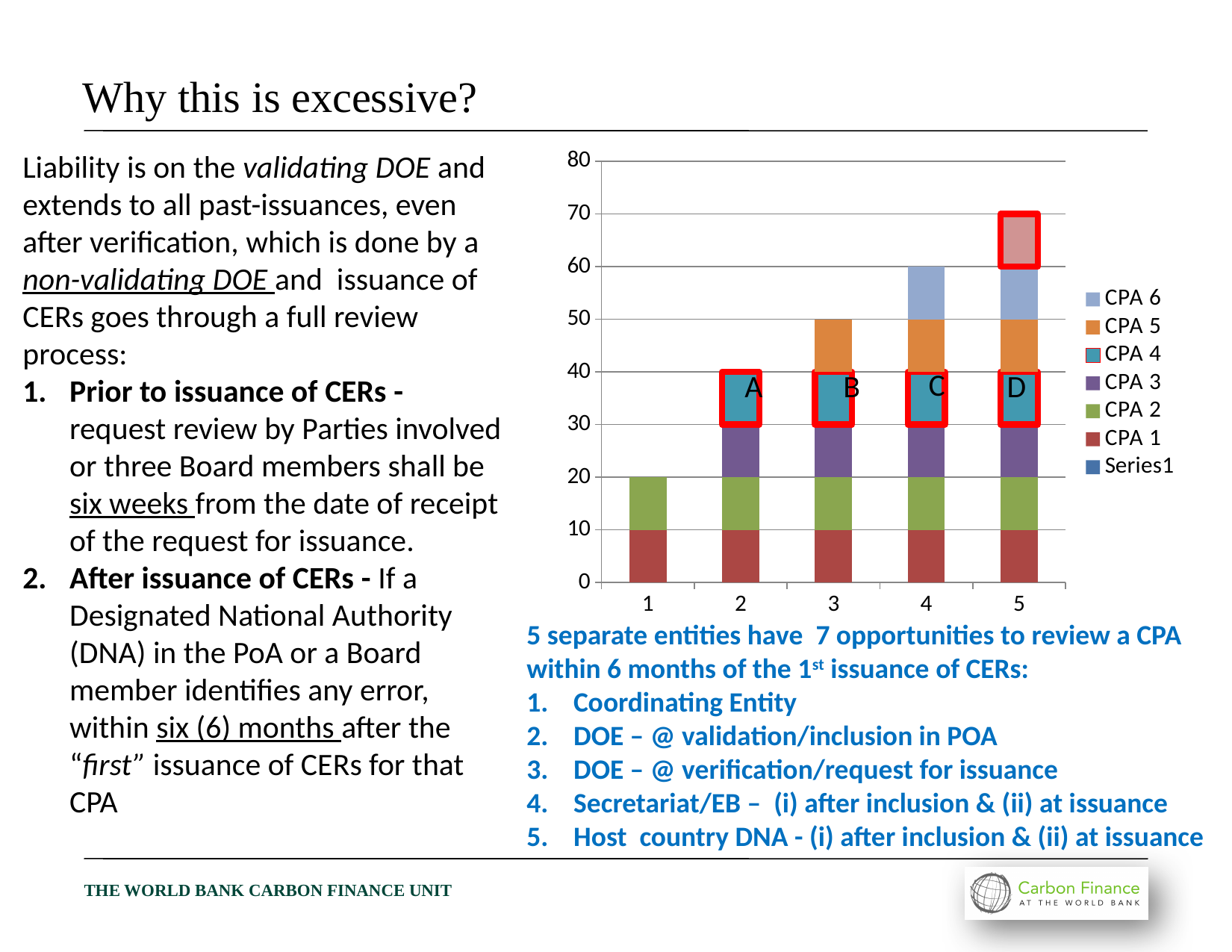
What is the difference between the stacked bar totals for category 3 and category 1? 30 What kind of chart is shown on the slide? Stacked bar chart Do the stacked bar totals rise or fall from category 1 to category 4? rise Which series is listed first (at the top) in the chart's legend? CPA 6 How many categories are shown on the x axis of the chart? 5 Which stacked bar is taller, category 2 or category 3? 3 What is the total height of the stacked bar for category 2? 40 Which category has the lowest stacked bar total? 1 How many series does the chart's legend list? 7 What is the total height of the stacked bar for category 1? 20 What is the total height of the stacked bar for category 3? 50 Is the total for category 4 greater or less than 50? greater